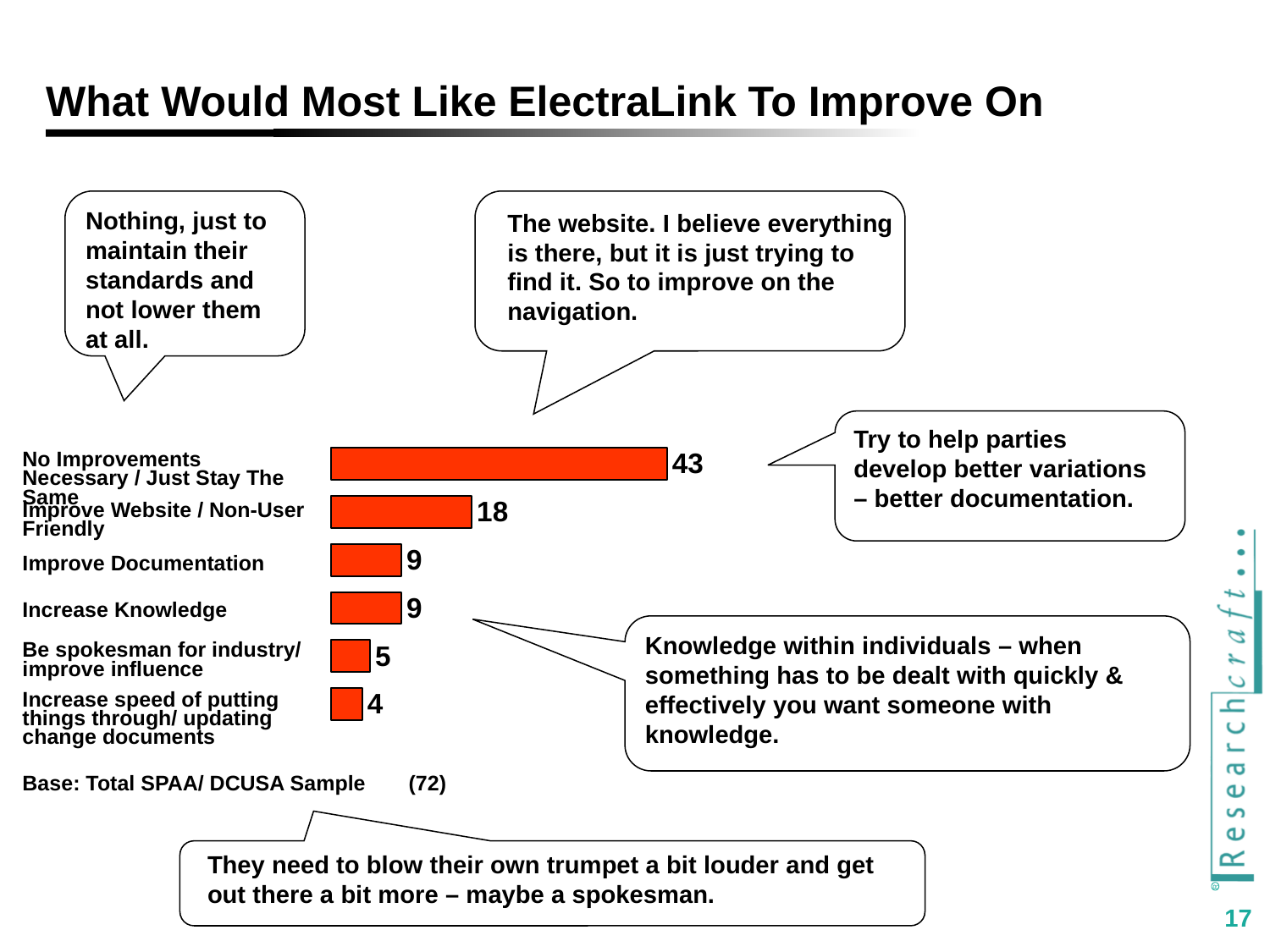
What is the difference between the values for 'No Improvements Necessary / Just Stay The Same' and 'Improve Website / Non-User Friendly'? 25 What is the value for 'Improve Documentation'? 9 What is the value for 'Increase speed of putting things through/ updating change documents'? 4 What is the value for 'Be spokesman for industry/ improve influence'? 5 Which is larger: the value for 'Improve Website / Non-User Friendly' or the value for 'Increase Knowledge'? Improve Website / Non-User Friendly What is the base sample size stated below the chart? 72 Which category has the lowest value? Increase speed of putting things through/ updating change documents What kind of chart is shown on the slide? Bar chart How many categories are shown in the chart? 6 What is the value for 'No Improvements Necessary / Just Stay The Same'? 43 What is the value for 'Improve Website / Non-User Friendly'? 18 Which category has the highest value? No Improvements Necessary / Just Stay The Same